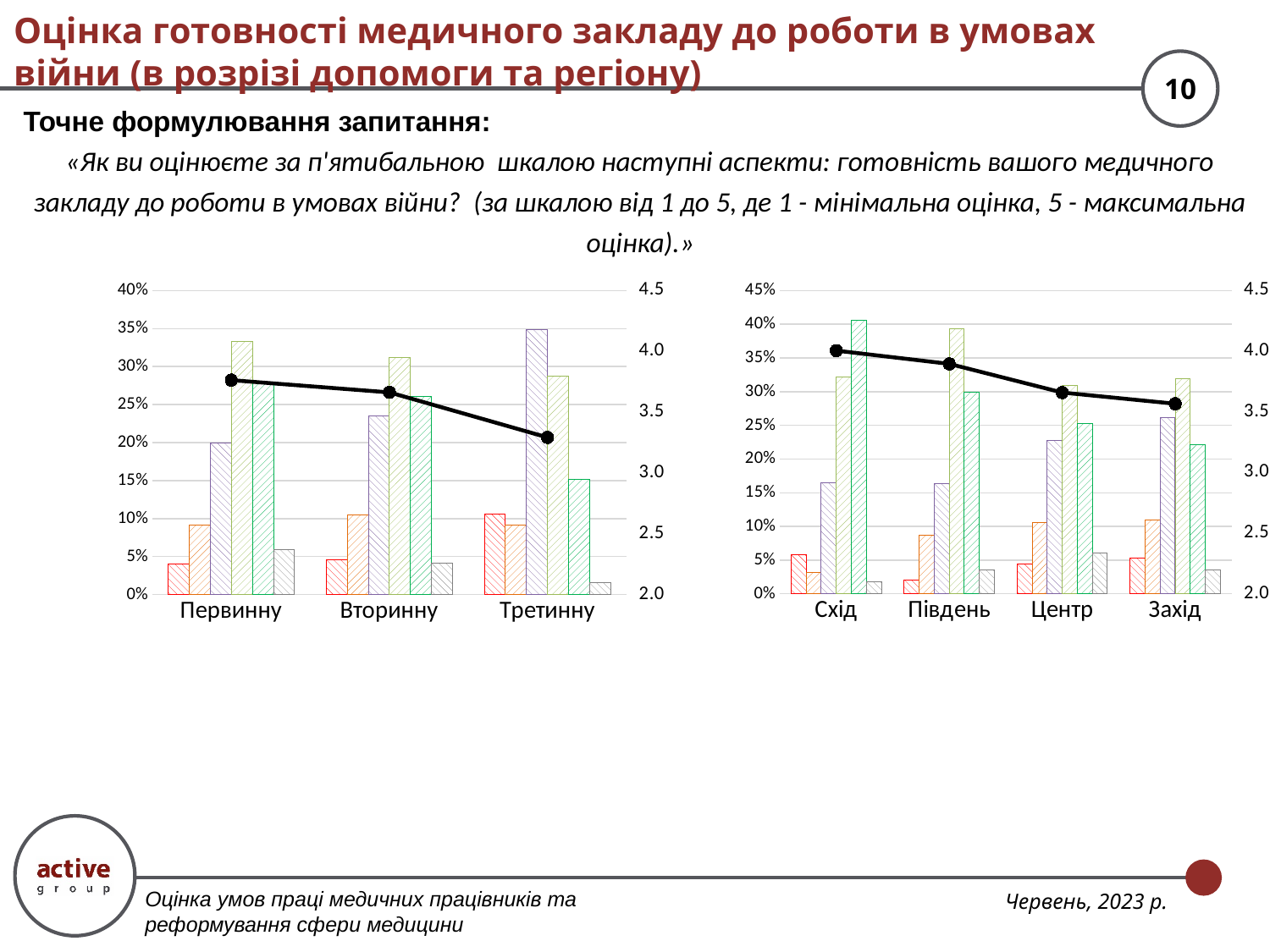
On the left chart, how many categories are shown on the x axis? 3 On the right chart, which category has the highest value on the black line? Схід On the right chart, is the black line value for Південь greater or less than 3.5? greater On the left chart, does the black line rise or fall from Первинну to Третинну? fall On the left chart, is the black line value for Третинну greater or less than 3.5? less What kind of chart is the left chart? bar and line chart On the left chart, which category has the highest value on the black line? Первинну On the right chart, does the black line rise or fall from Схід to Захід? fall On the left chart, is the tallest bar in the Третинну group greater or less than 30%? greater On the left chart, which category has the lowest value on the black line? Третинну On the right chart, which category has the lowest value on the black line? Захід On the right chart, how many categories are shown on the x axis? 4